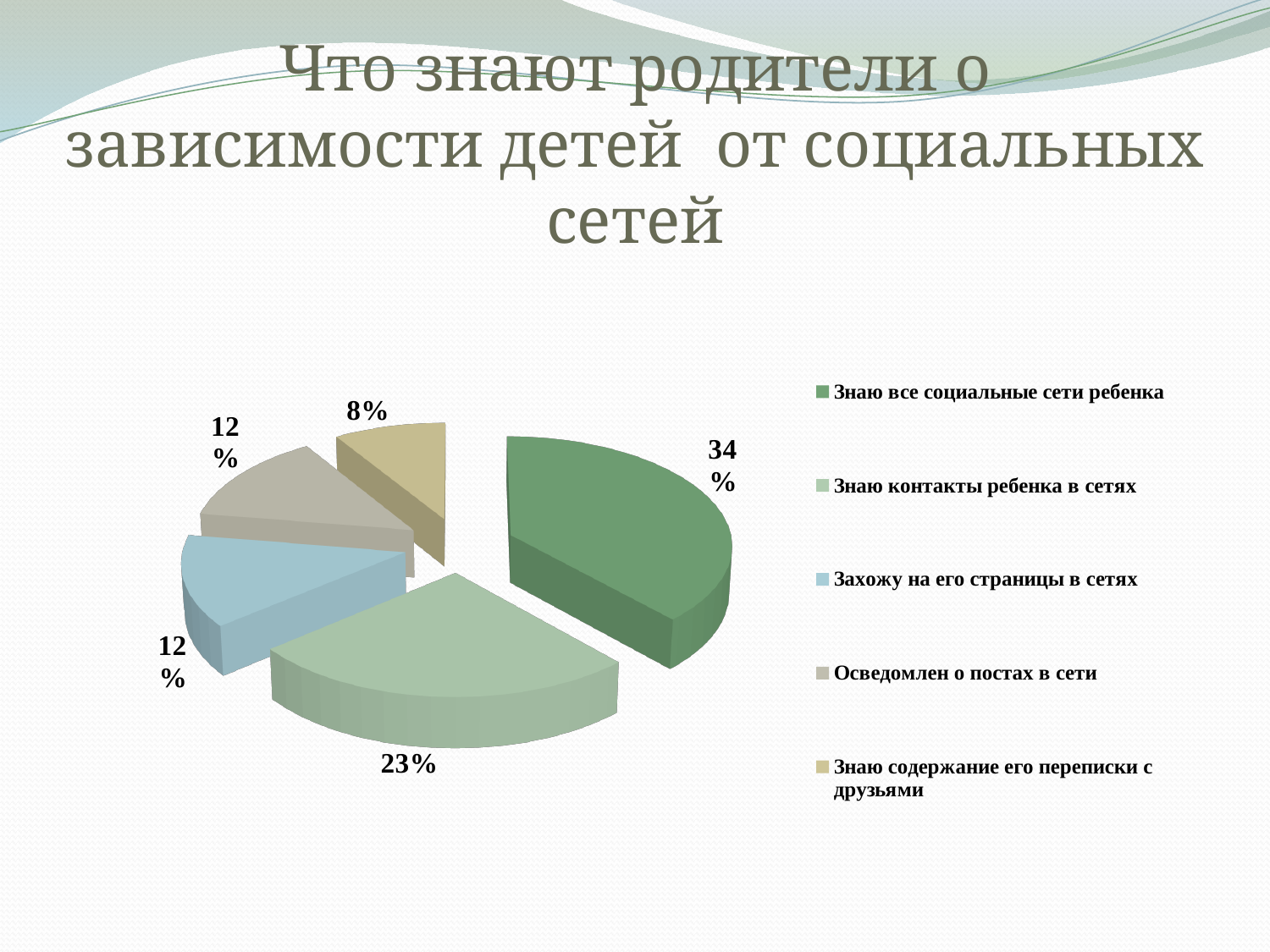
How many slices does the pie chart have? 5 What share of the pie is labelled "Захожу на его страницы в сетях"? 12% What is the title of the slide containing the chart? Что знают родители о зависимости детей от социальных сетей Which category has the largest slice of the pie? Знаю все социальные сети ребенка What is the difference in percentage points between "Знаю все социальные сети ребенка" and "Знаю контакты ребенка в сетях"? 11 What share of the pie is labelled "Знаю содержание его переписки с друзьями"? 8% Which is larger: the slice for "Осведомлен о постах в сети" or the slice for "Знаю содержание его переписки с друзьями"? Осведомлен о постах в сети Which category has the smallest slice of the pie? Знаю содержание его переписки с друзьями What share of the pie is labelled "Знаю контакты ребенка в сетях"? 23% How many entries does the legend list? 5 What type of chart is shown on the slide? pie chart